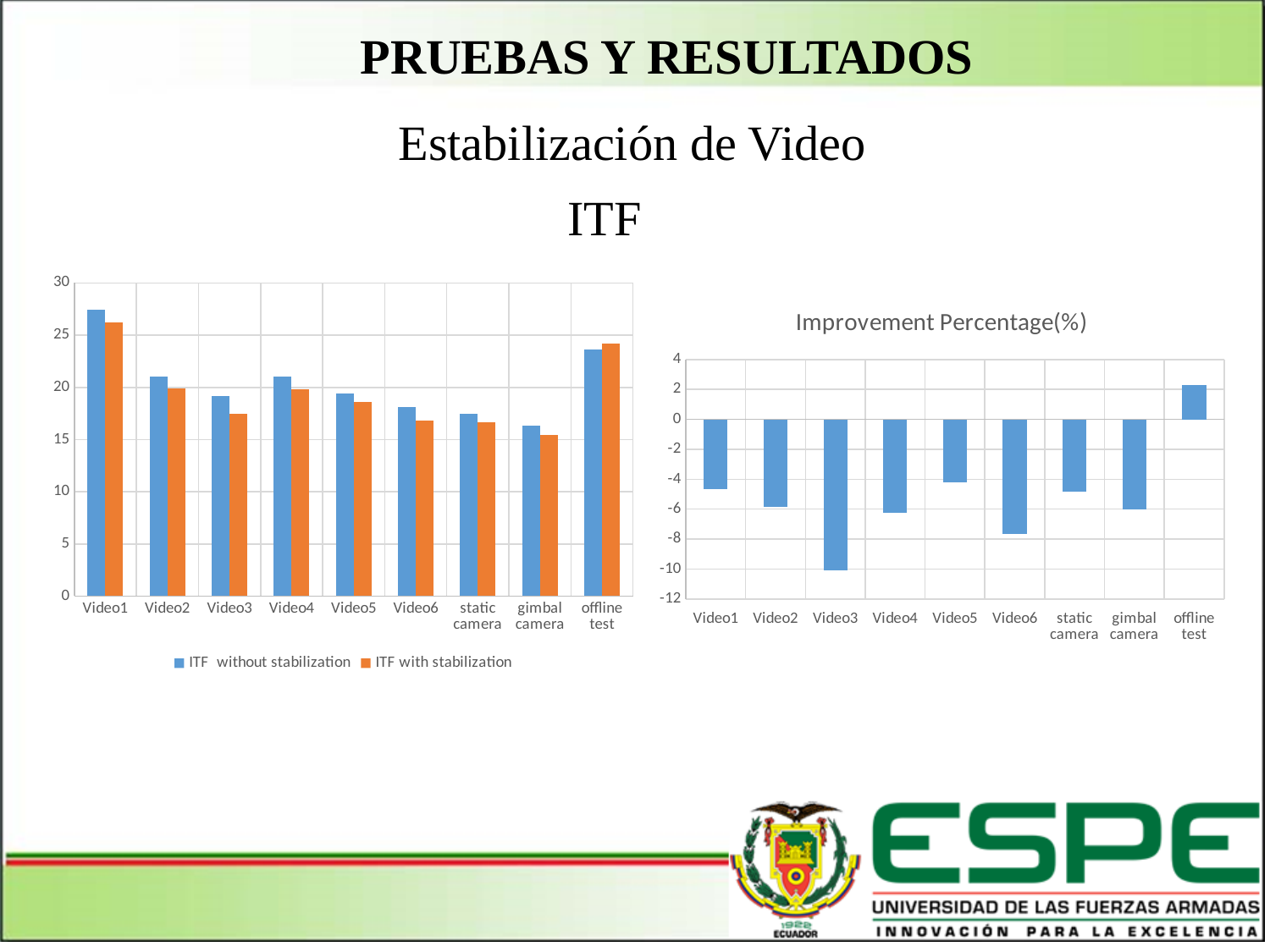
In the left chart, is the ITF without stabilization for Video1 greater or less than 25? greater In the left chart, is the ITF with stabilization for Video3 greater or less than 20? less In the Improvement Percentage(%) chart, which category has the lowest value? Video3 In the left chart, which category has the highest ITF without stabilization? Video1 What are the two legend entries of the left chart? ITF without stabilization; ITF with stabilization How many series does the legend of the left chart list? 2 In the Improvement Percentage(%) chart, which category has the highest value? offline test How many categories are shown on the x axis of the left chart? 9 In the left chart, for Video1, which is larger: ITF without stabilization or ITF with stabilization? ITF without stabilization What kind of chart is the left chart on the slide? bar chart In the Improvement Percentage(%) chart, is the value for Video3 greater or less than -8? less In the left chart, which category has the lowest ITF with stabilization? gimbal camera